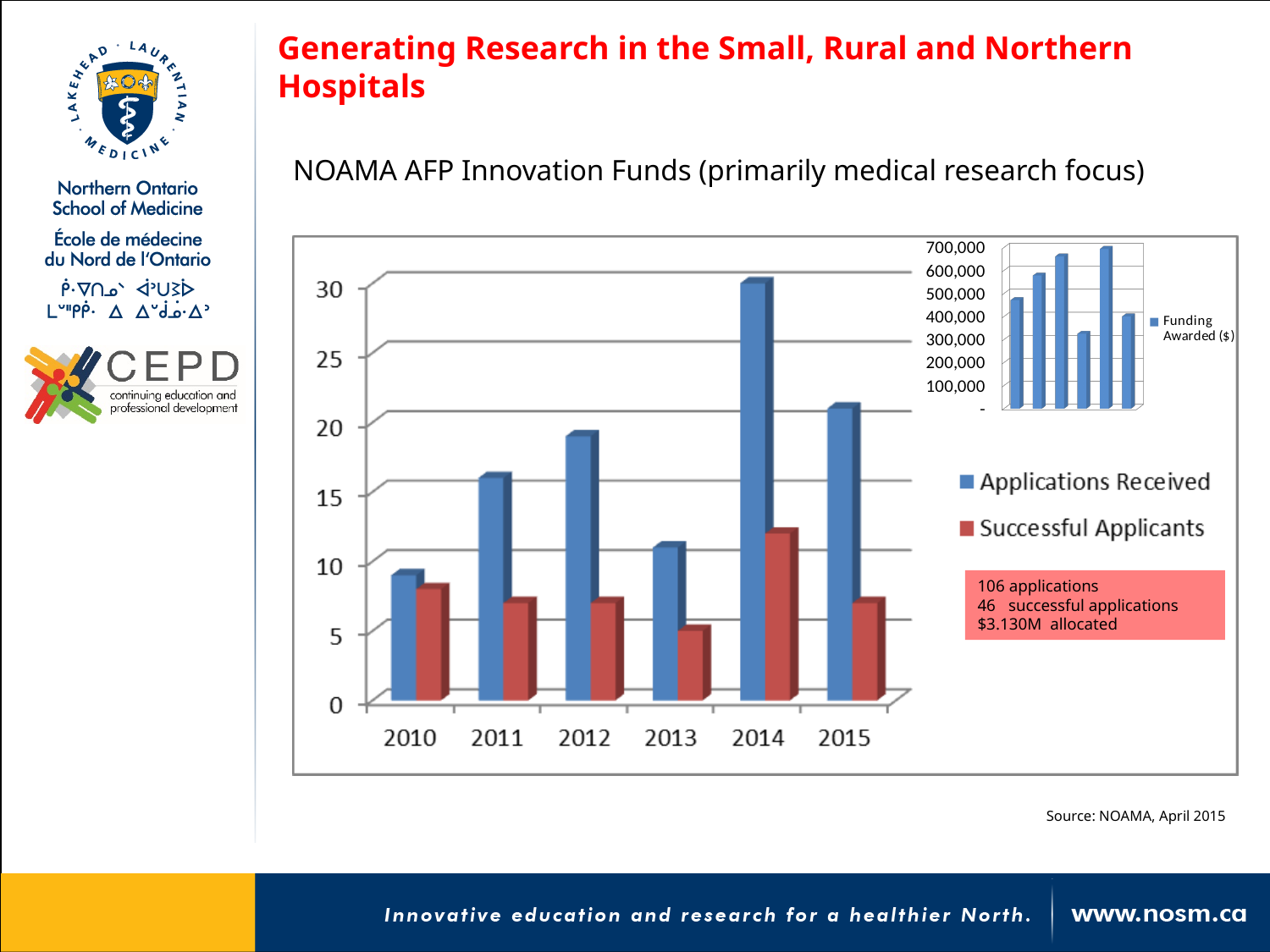
In the main chart, which year has the highest number of Successful Applicants? 2014 What kind of chart is the main chart on the slide? bar chart In the main chart, do Applications Received rise or fall from 2014 to 2015? fall In the main chart, which year has the lowest number of Applications Received? 2010 What series name does the legend of the small inset chart in the top right show? Funding Awarded ($) In the main chart, which year had more Applications Received, 2011 or 2012? 2012 How many series does the legend of the main chart list? 2 In the main chart, is the value for Applications Received in 2014 greater or less than 25? greater In the main chart, which year has the lowest number of Successful Applicants? 2013 In the main chart, is the value for Applications Received in 2013 greater or less than 15? less How many years are shown on the x axis of the main chart? 6 In the main chart, which year has the highest number of Applications Received? 2014